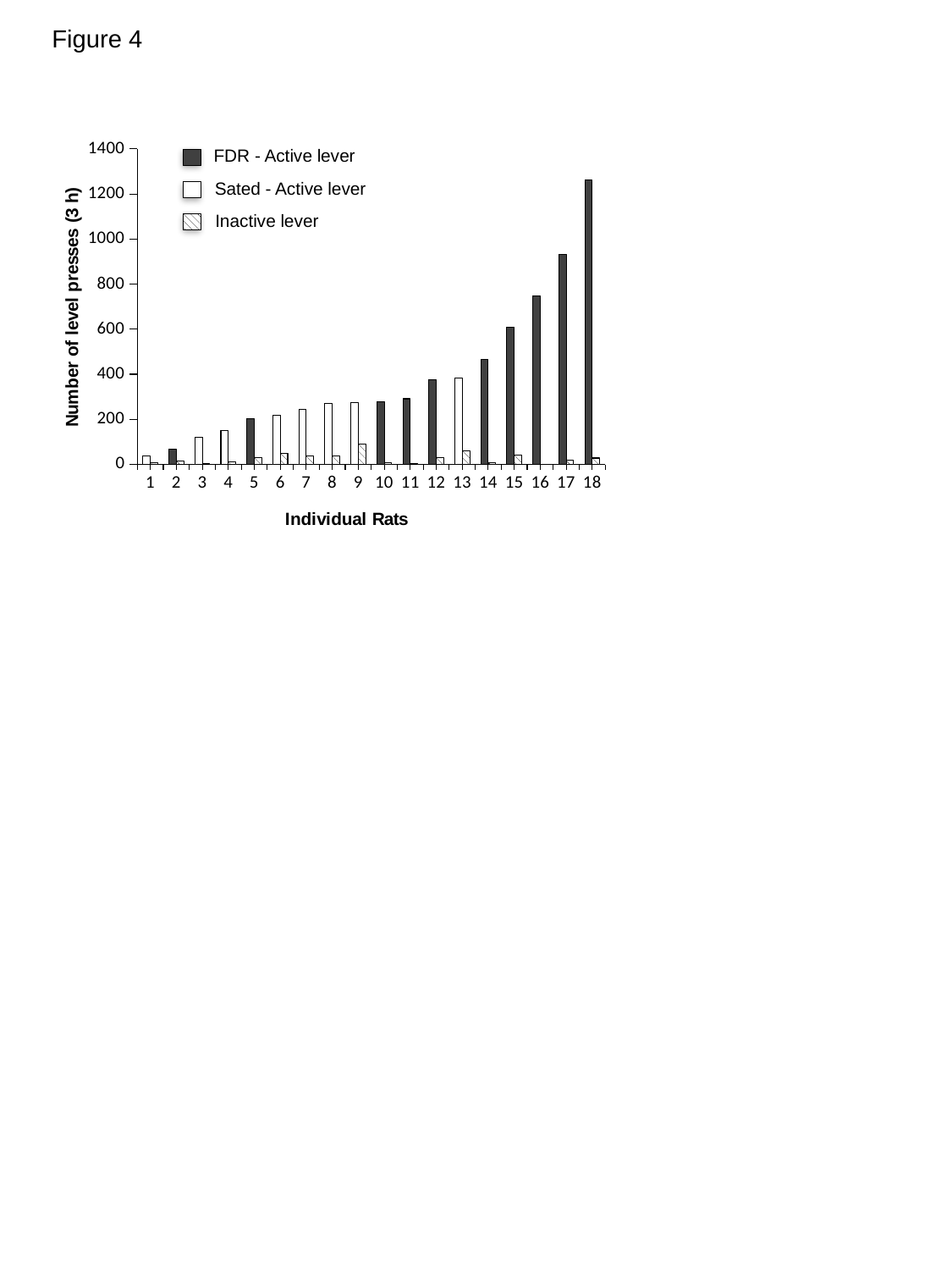
Is the FDR - Active lever value for rat 17 greater or less than 800? greater What is the title of the y axis? Number of level presses (3 h) Is the FDR - Active lever value for rat 18 greater or less than 1200? greater How many individual rats are shown on the x axis? 18 Is the Sated - Active lever value for rat 3 greater or less than 200? less Which is larger, the FDR - Active lever value for rat 17 or for rat 16? rat 17 What kind of chart is shown on the slide? bar chart Which is larger, the Inactive lever value for rat 9 or for rat 1? rat 9 Do the FDR - Active lever values rise or fall from rat 10 to rat 18? rise How many series does the legend list? 3 Which rat has the highest FDR - Active lever value? 18